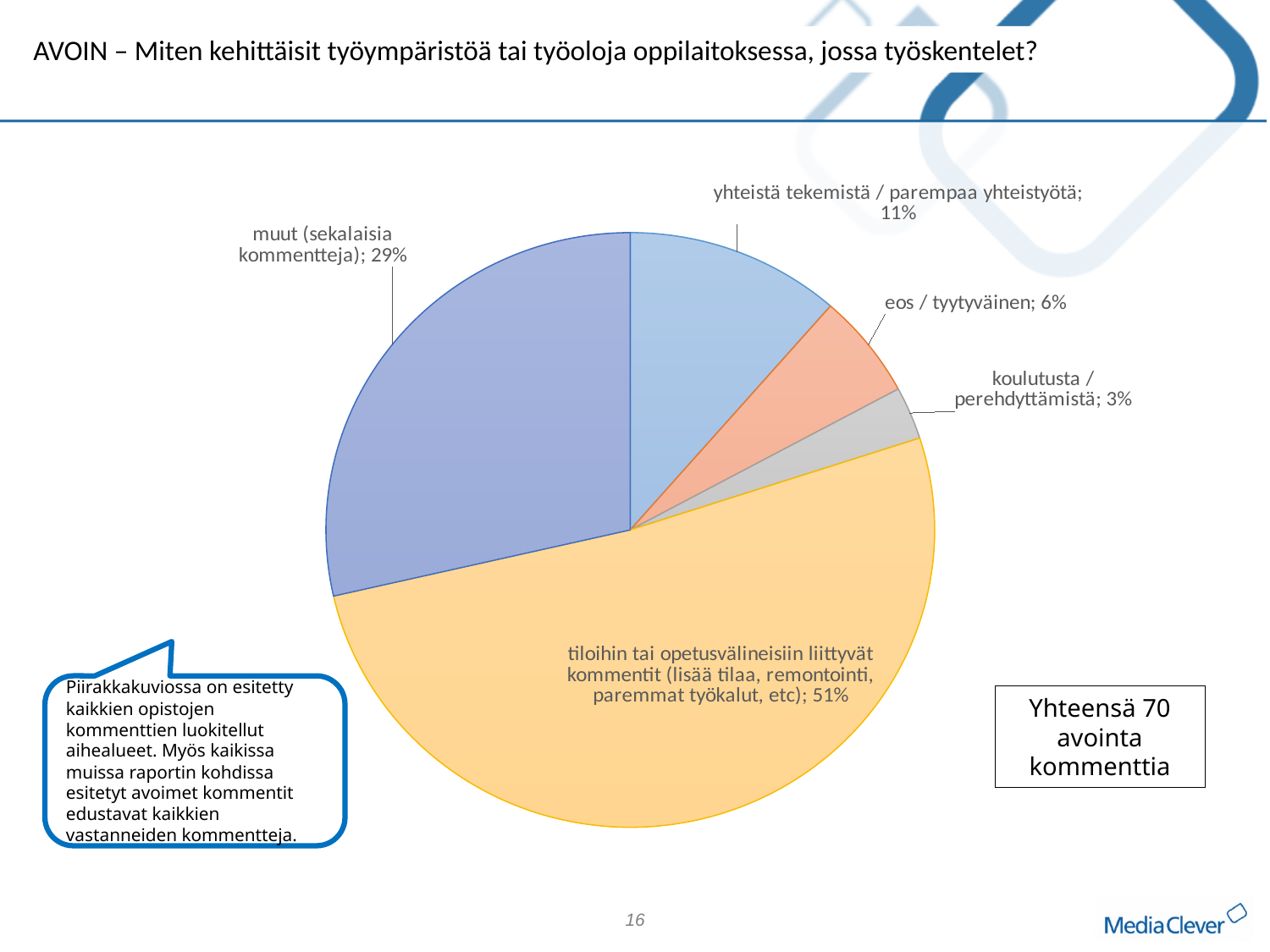
How many slices does the pie chart have? 5 What is the difference in percentage points between 'muut (sekalaisia kommentteja)' and 'yhteistä tekemistä / parempaa yhteistyötä'? 18 percentage points What is the value for 'yhteistä tekemistä / parempaa yhteistyötä'? 11% What share of the pie is 'tiloihin tai opetusvälineisiin liittyvät kommentit (lisää tilaa, remontointi, paremmat työkalut, etc)'? 51% What is the value for 'koulutusta / perehdyttämistä'? 3% Which is larger, 'eos / tyytyväinen' or 'koulutusta / perehdyttämistä'? eos / tyytyväinen What kind of chart is shown on the slide? pie chart Which category has the smallest slice of the pie? koulutusta / perehdyttämistä According to the box on the slide, how many open comments were there in total? 70 What is the value for 'eos / tyytyväinen'? 6% What share of the pie is 'muut (sekalaisia kommentteja)'? 29% Which category has the largest slice of the pie? tiloihin tai opetusvälineisiin liittyvät kommentit (lisää tilaa, remontointi, paremmat työkalut, etc)